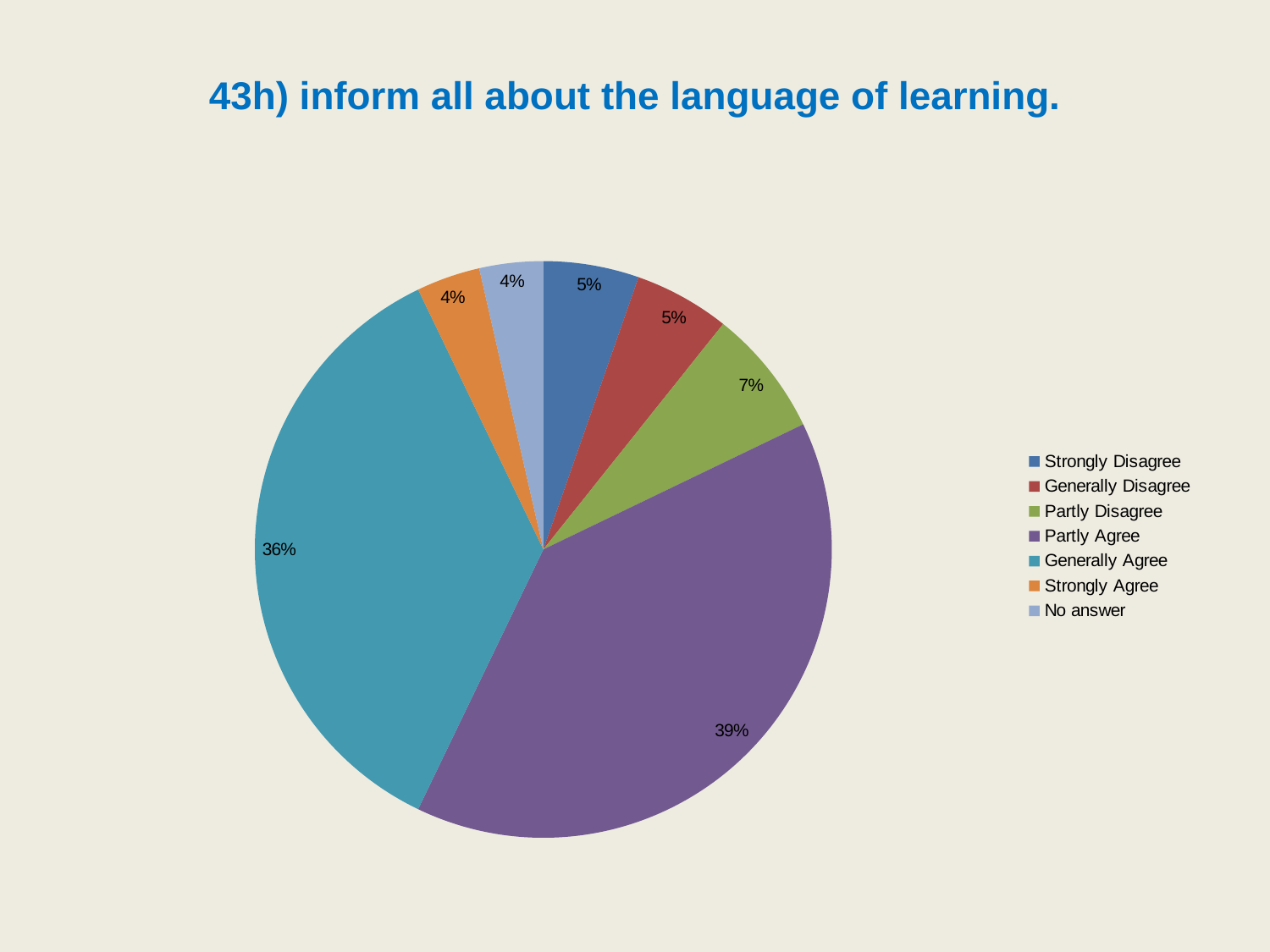
Which is larger, Partly Agree or Generally Agree? Partly Agree What share of the pie does Partly Agree take? 39% What is the value for Partly Disagree? 7% Which category has the largest slice of the pie? Partly Agree What is the title of the chart? 43h) inform all about the language of learning. Which legend entry is shown in orange? Strongly Agree What is the value for Generally Agree? 36% How many slices does the pie chart have? 7 What is the value for Strongly Disagree? 5% What is the difference between the Partly Agree and Generally Agree values? 3% What kind of chart is shown on the slide? pie chart What is the value for Strongly Agree? 4%